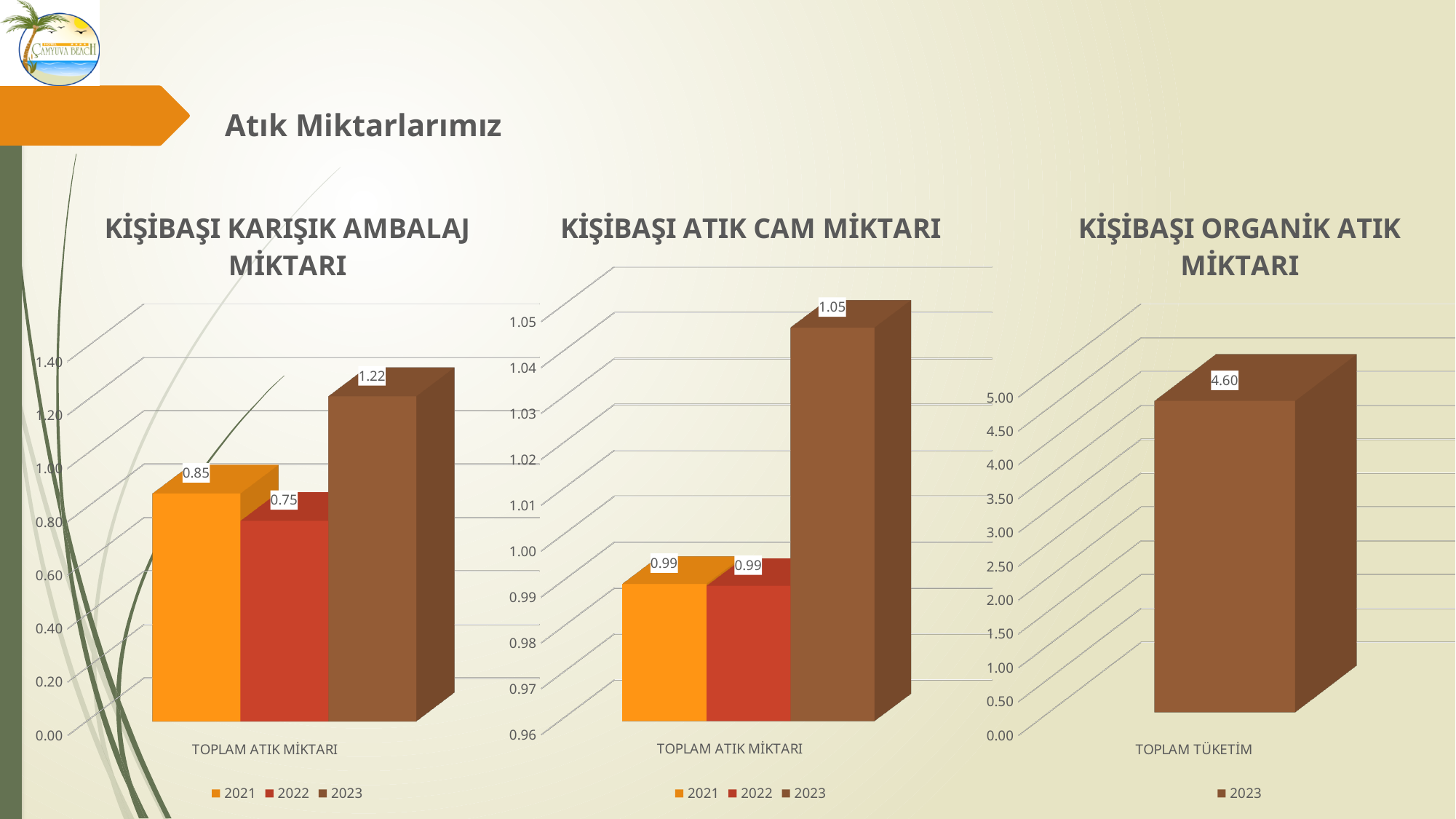
In the 'KİŞİBAŞI KARIŞIK AMBALAJ MİKTARI' chart, which year has the lowest value? 2022 In the 'KİŞİBAŞI KARIŞIK AMBALAJ MİKTARI' chart, how many series does the legend list? 3 In the 'KİŞİBAŞI ORGANİK ATIK MİKTARI' chart, what is the value for 2023? 4.60 In the 'KİŞİBAŞI KARIŞIK AMBALAJ MİKTARI' chart, what is the value for 2022? 0.75 In the 'KİŞİBAŞI KARIŞIK AMBALAJ MİKTARI' chart, what is the difference between the 2023 and 2021 values? 0.37 In the 'KİŞİBAŞI ORGANİK ATIK MİKTARI' chart, how many series does the legend list? 1 In the 'KİŞİBAŞI ATIK CAM MİKTARI' chart, what is the difference between the 2023 and 2022 values? 0.06 What kind of chart is the 'KİŞİBAŞI ORGANİK ATIK MİKTARI' chart? Bar chart In the 'KİŞİBAŞI ATIK CAM MİKTARI' chart, which year has the highest value? 2023 In the 'KİŞİBAŞI ATIK CAM MİKTARI' chart, what is the value for 2023? 1.05 In the 'KİŞİBAŞI ATIK CAM MİKTARI' chart, what is the value for 2021? 0.99 In the 'KİŞİBAŞI KARIŞIK AMBALAJ MİKTARI' chart, what is the value for 2023? 1.22